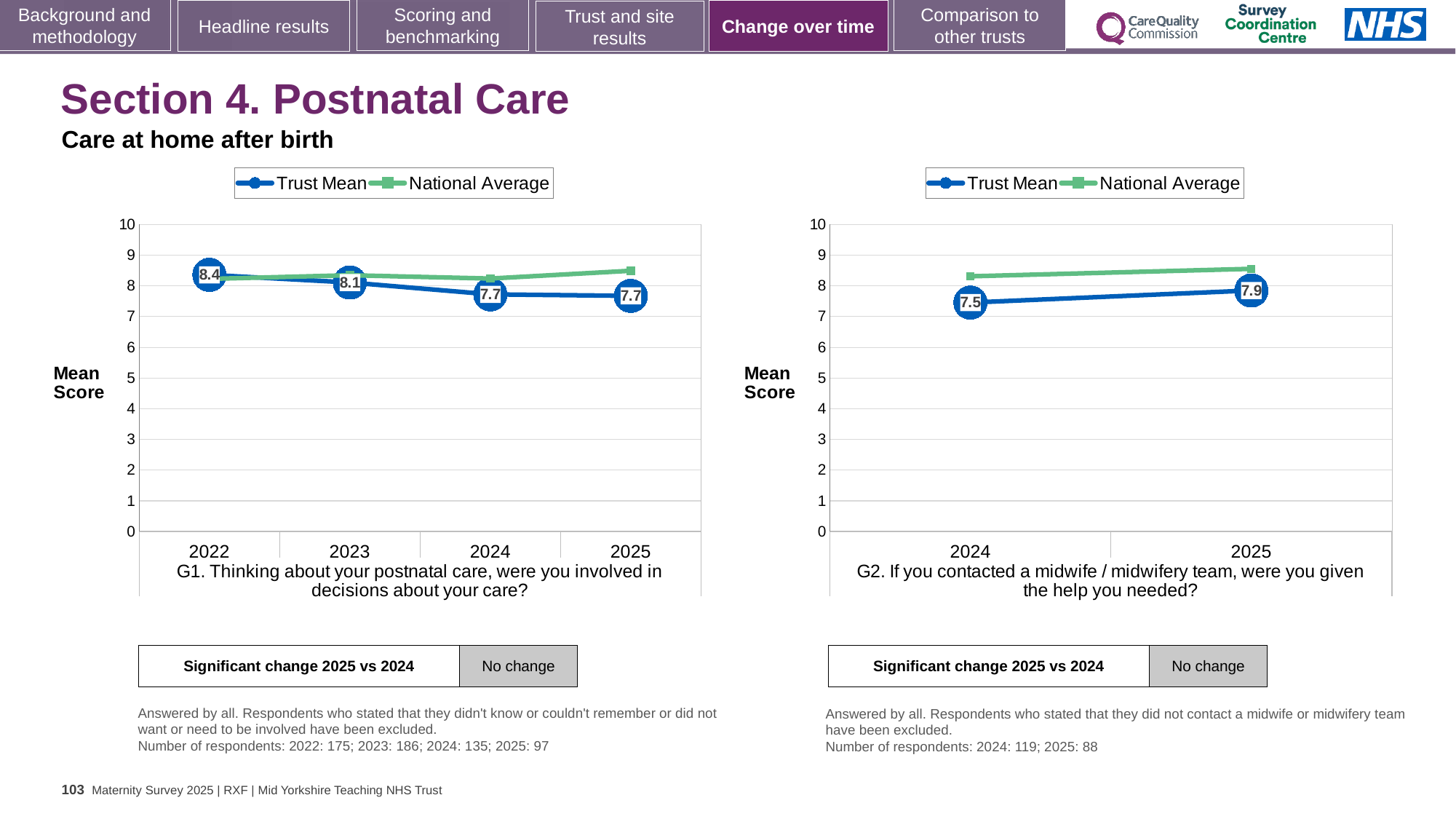
In the G1 chart on the left, is the National Average value for 2025 greater or less than 8? greater How many years are shown on the x axis of the G1 chart on the left? 4 What kind of chart is the G2 chart on the right? Line chart In the G1 chart on the left, what is the Trust Mean score for 2022? 8.4 In the G2 chart on the right, which year has the lowest Trust Mean score? 2024 In the G1 chart on the left, what is the difference between the Trust Mean scores for 2022 and 2025? 0.7 In the G1 chart on the left, what is the Trust Mean score for 2024? 7.7 In the G1 chart on the left, which year has the larger Trust Mean score, 2022 or 2023? 2022 In the G2 chart on the right, what is the Trust Mean score for 2025? 7.9 How many series does the legend of the G2 chart on the right list? 2 In the G1 chart on the left, which year has the highest Trust Mean score? 2022 In the G2 chart on the right, what is the difference between the Trust Mean scores for 2025 and 2024? 0.4